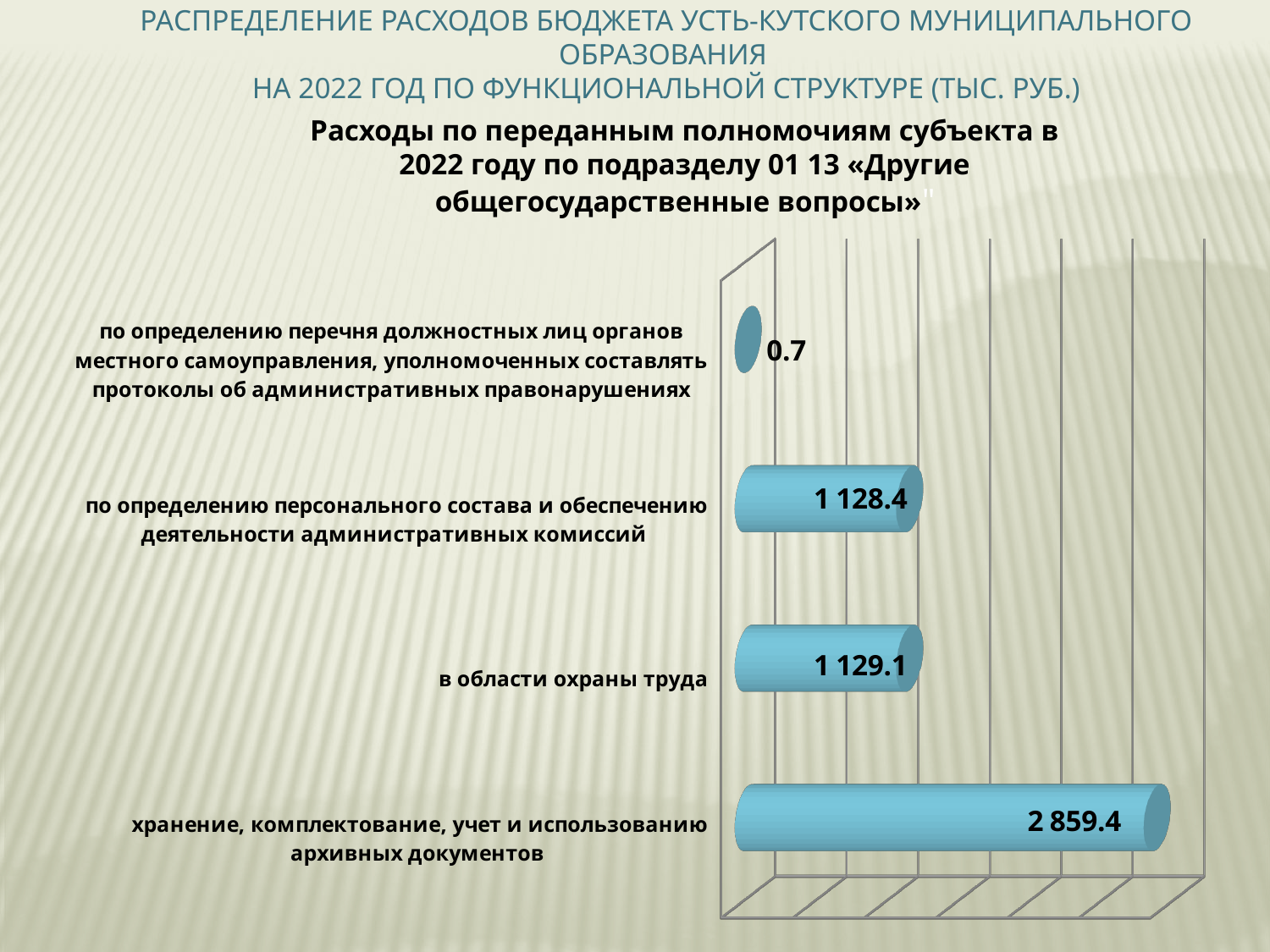
What is the value for «хранение, комплектование, учет и использованию архивных документов»? 2 859.4 Which category has the lowest value? по определению перечня должностных лиц органов местного самоуправления, уполномоченных составлять протоколы об административных правонарушениях Which category has the highest value? хранение, комплектование, учет и использованию архивных документов What kind of chart is shown on the slide? bar chart Which is larger: the value for «хранение, комплектование, учет и использованию архивных документов» or the value for «в области охраны труда»? хранение, комплектование, учет и использованию архивных документов What is the difference between the value for «хранение, комплектование, учет и использованию архивных документов» and the value for «в области охраны труда»? 1 730.3 What is the value for «в области охраны труда»? 1 129.1 How many categories are shown in the chart? 4 What is the difference between the value for «в области охраны труда» and the value for «по определению персонального состава и обеспечению деятельности административных комиссий»? 0.7 What is the value for «по определению персонального состава и обеспечению деятельности административных комиссий»? 1 128.4 What is the title of the chart? Расходы по переданным полномочиям субъекта в 2022 году по подразделу 01 13 «Другие общегосударственные вопросы» What is the value for «по определению перечня должностных лиц органов местного самоуправления, уполномоченных составлять протоколы об административных правонарушениях»? 0.7